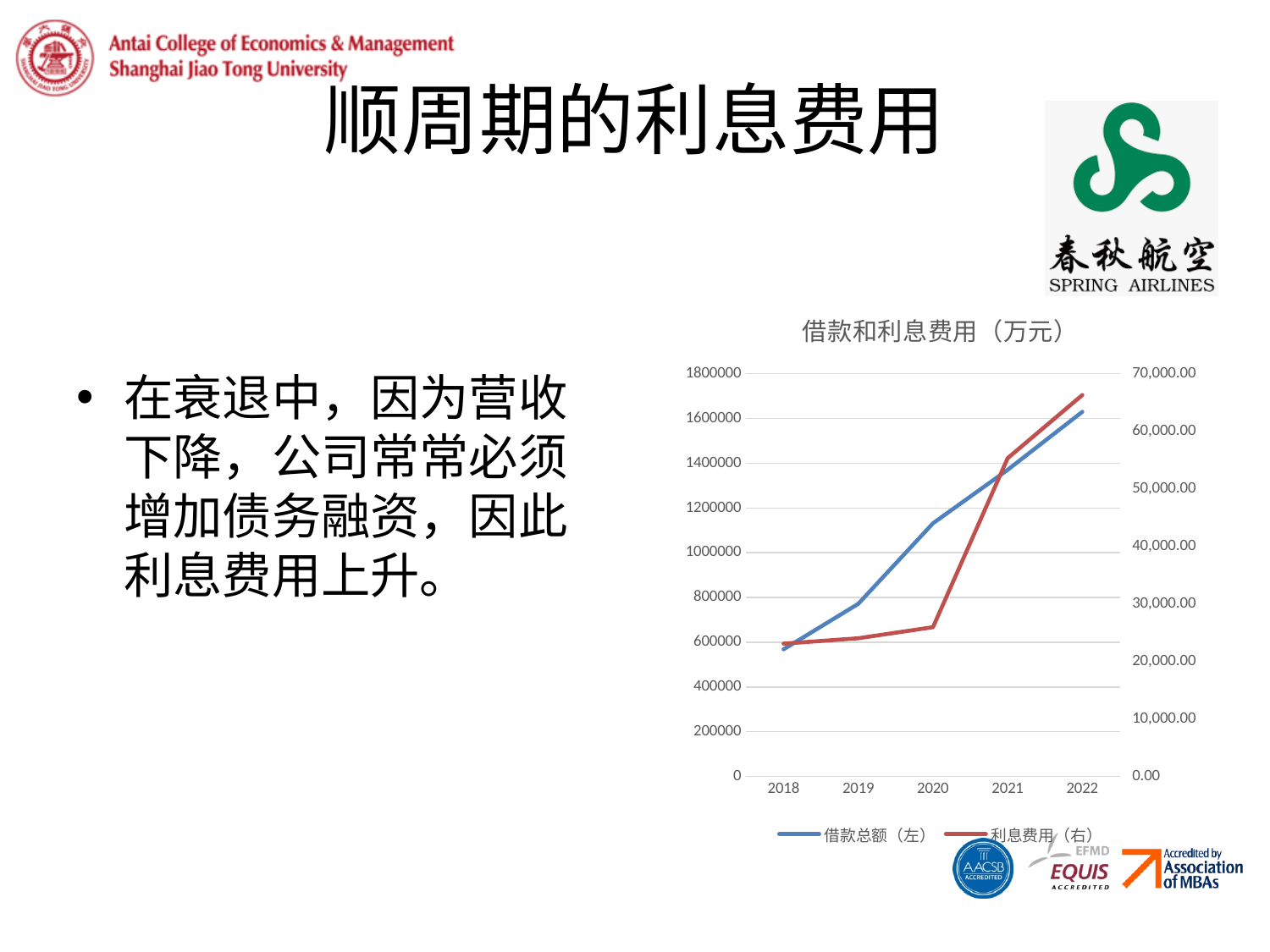
Is the value of 借款总额（左） in 2018 greater or less than 800000? less Is the value of 借款总额（左） in 2020 greater or less than 1000000? greater How many series does the chart legend list? 2 What is the title of the chart? 借款和利息费用（万元） How many years are plotted along the x axis of the chart? 5 Is the value of 利息费用（右） in 2020 greater or less than 30,000.00? less What kind of chart is shown on the slide? Line chart Which axis, left or right, is the 利息费用 series plotted against? Right Does the 借款总额（左） series rise or fall from 2018 to 2022? Rise Does the 利息费用（右） series rise or fall from 2018 to 2022? Rise